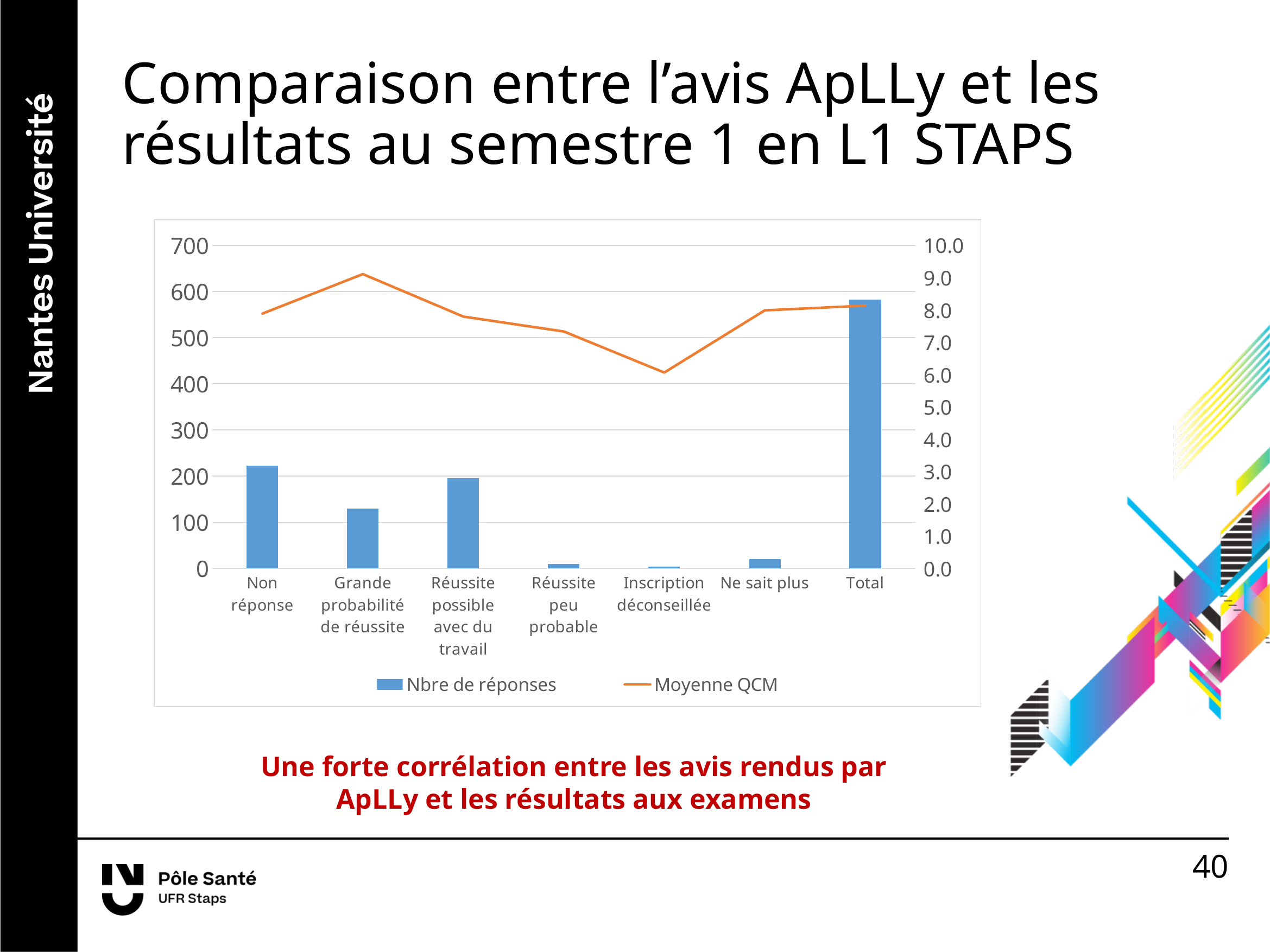
How many categories are shown along the x axis of the chart? 7 Which category has the tallest bar for Nbre de réponses? Total Is the Nbre de réponses value for Total greater or less than 500? greater What kind of chart is shown on the slide? A combined bar and line chart For which category is the Moyenne QCM line at its highest point? Grande probabilité de réussite Which has more Nbre de réponses: Non réponse or Grande probabilité de réussite? Non réponse Is the Moyenne QCM value for Inscription déconseillée greater or less than 7.0? less How many series does the chart legend list? 2 What colour is the Moyenne QCM line in the chart? Orange For which category is the Moyenne QCM line at its lowest point? Inscription déconseillée Is the Nbre de réponses value for Non réponse greater or less than 200? greater Which category has the smallest bar for Nbre de réponses? Inscription déconseillée